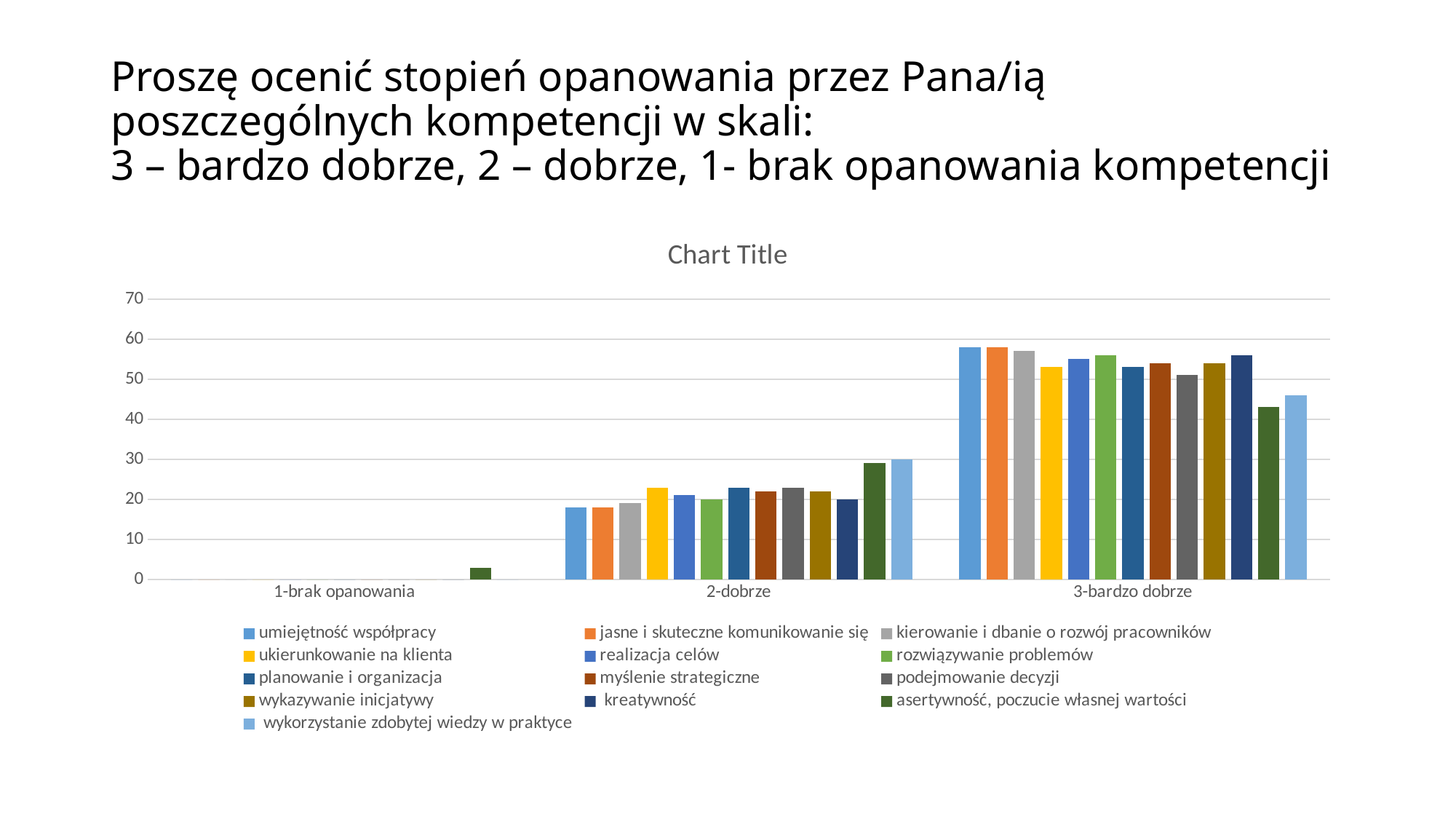
What is the title shown above the chart? Chart Title What is the value for 'wykorzystanie zdobytej wiedzy w praktyce' in the '2-dobrze' category? 30 Is the value for 'asertywność, poczucie własnej wartości' in the '1-brak opanowania' category greater or less than 10? less What kind of chart is shown on the slide? bar chart Which series has the lowest value in the '3-bardzo dobrze' category? asertywność, poczucie własnej wartości How many categories are shown on the x axis of the chart? 3 How many series does the chart legend list? 13 Do the values for 'umiejętność współpracy' rise or fall from '1-brak opanowania' to '3-bardzo dobrze'? rise Is the value for 'wykorzystanie zdobytej wiedzy w praktyce' in the '3-bardzo dobrze' category greater or less than 50? less In the '2-dobrze' category, which is larger: 'asertywność, poczucie własnej wartości' or 'umiejętność współpracy'? asertywność, poczucie własnej wartości Is the value for 'umiejętność współpracy' in the '3-bardzo dobrze' category greater or less than 50? greater